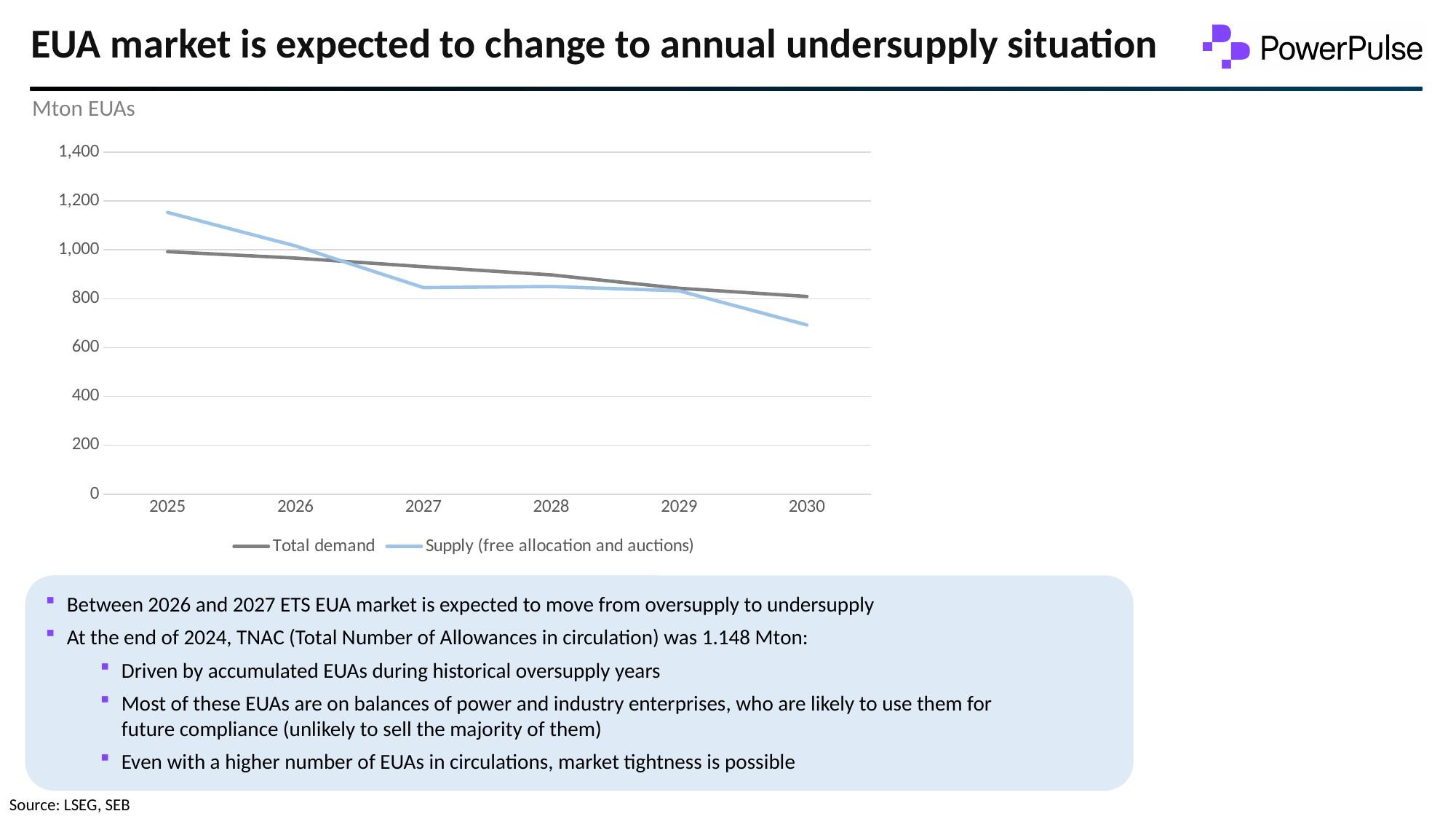
How many series does the legend list? 2 In which year is Supply (free allocation and auctions) lowest? 2030 Does the Total demand line rise or fall from 2025 to 2030? fall How many years are shown on the x axis? 6 What kind of chart is shown on the slide? line chart In 2025, which is larger: Total demand or Supply (free allocation and auctions)? Supply (free allocation and auctions) In which year is Supply (free allocation and auctions) highest? 2025 What unit is shown above the y axis of the chart? Mton EUAs Is the value for Supply (free allocation and auctions) in 2025 greater or less than 1,000? greater In 2030, which is larger: Total demand or Supply (free allocation and auctions)? Total demand Is the value for Supply (free allocation and auctions) in 2030 greater or less than 800? less